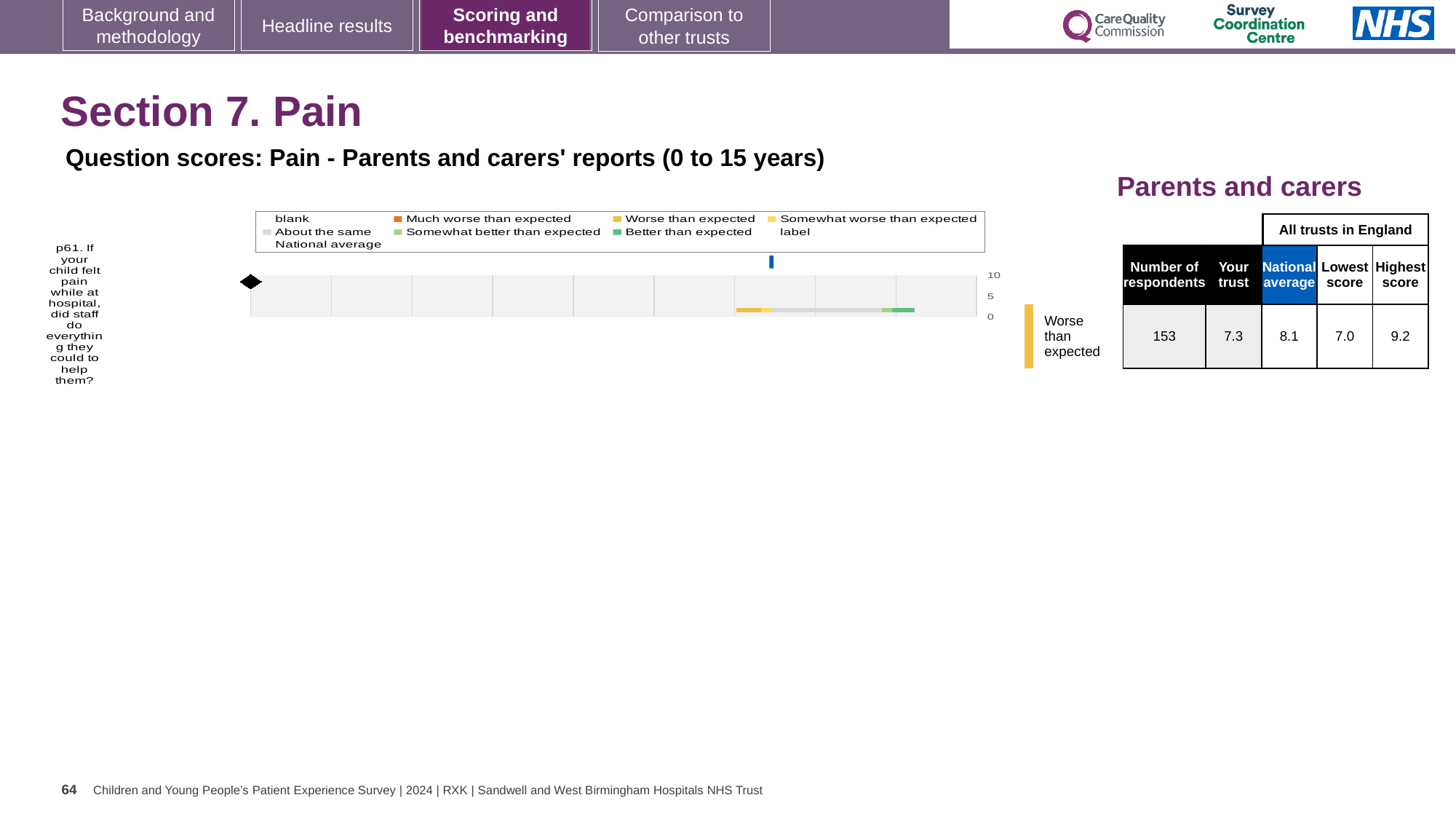
Is the 'Your trust' score for p61 higher or lower than the national average? lower Which question number is plotted in the chart? p61 In the table beside the chart, what is the highest score among all trusts in England for p61? 9.2 What colour does the legend use for 'Better than expected'? green How many survey questions are plotted in the chart? 1 In the table beside the chart, what is the 'Your trust' score for p61? 7.3 What is the difference between the highest score and the lowest score for p61 in the table? 2.2 How many entries does the chart's legend list? 9 What kind of chart is shown on the slide? bar chart In the table beside the chart, how many respondents answered p61? 153 In the table beside the chart, what is the lowest score among all trusts in England for p61? 7.0 In the table beside the chart, what is the national average score for p61? 8.1